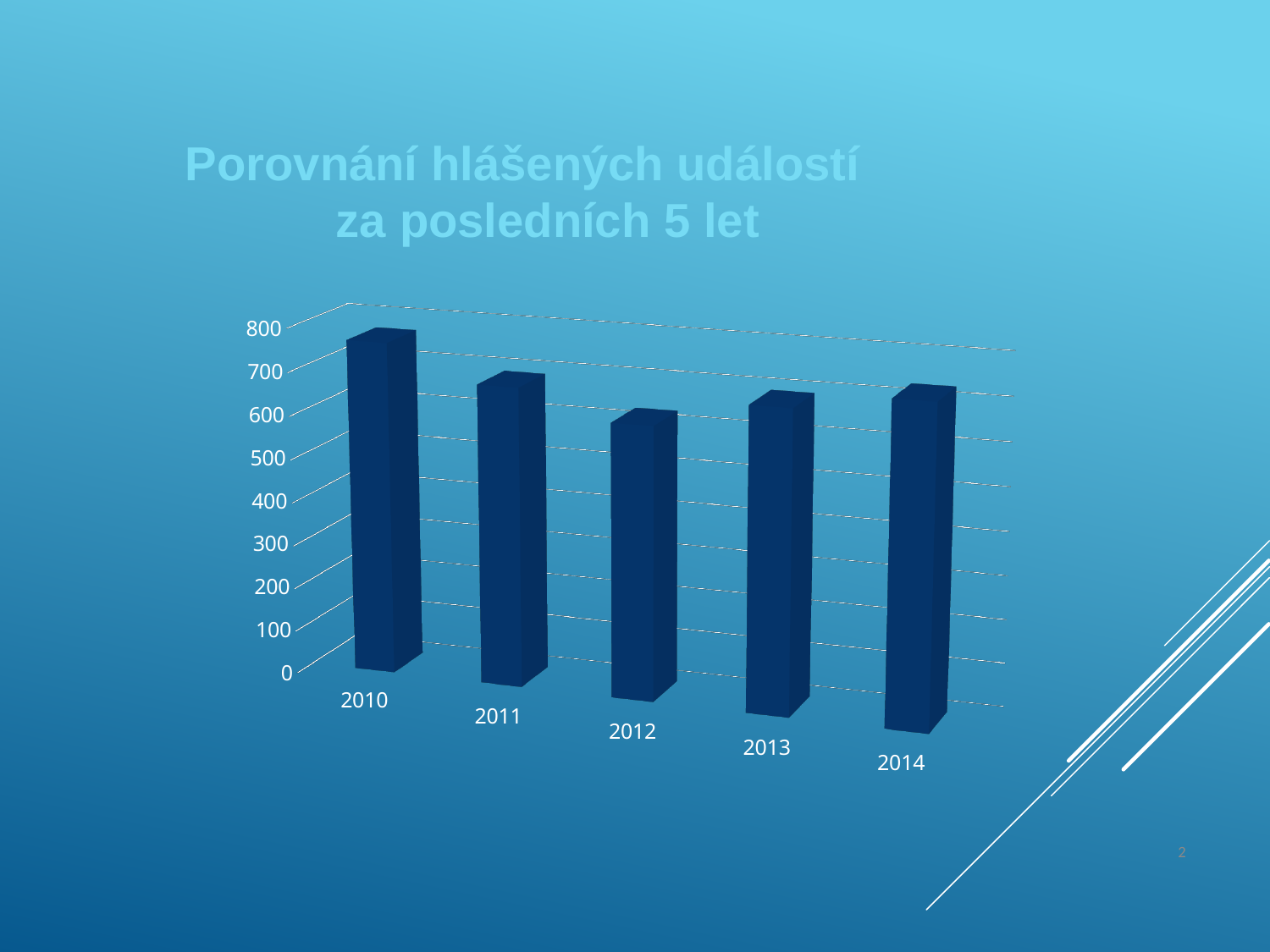
Is the value for 2010 greater or less than 600? greater Which year has the highest bar in the chart? 2010 How many years are shown on the x axis of the chart? 5 Is the value for 2014 greater or less than 800? less Is the value for 2012 greater or less than 800? less What is the title of the chart on the slide? Porovnání hlášených událostí za posledních 5 let Which year has the lowest bar in the chart? 2012 What kind of chart is shown on the slide? bar chart What is the highest value shown on the vertical axis of the chart? 800 Which is larger, the value for 2010 or the value for 2012? 2010 Do the values rise or fall from 2010 to 2012? fall